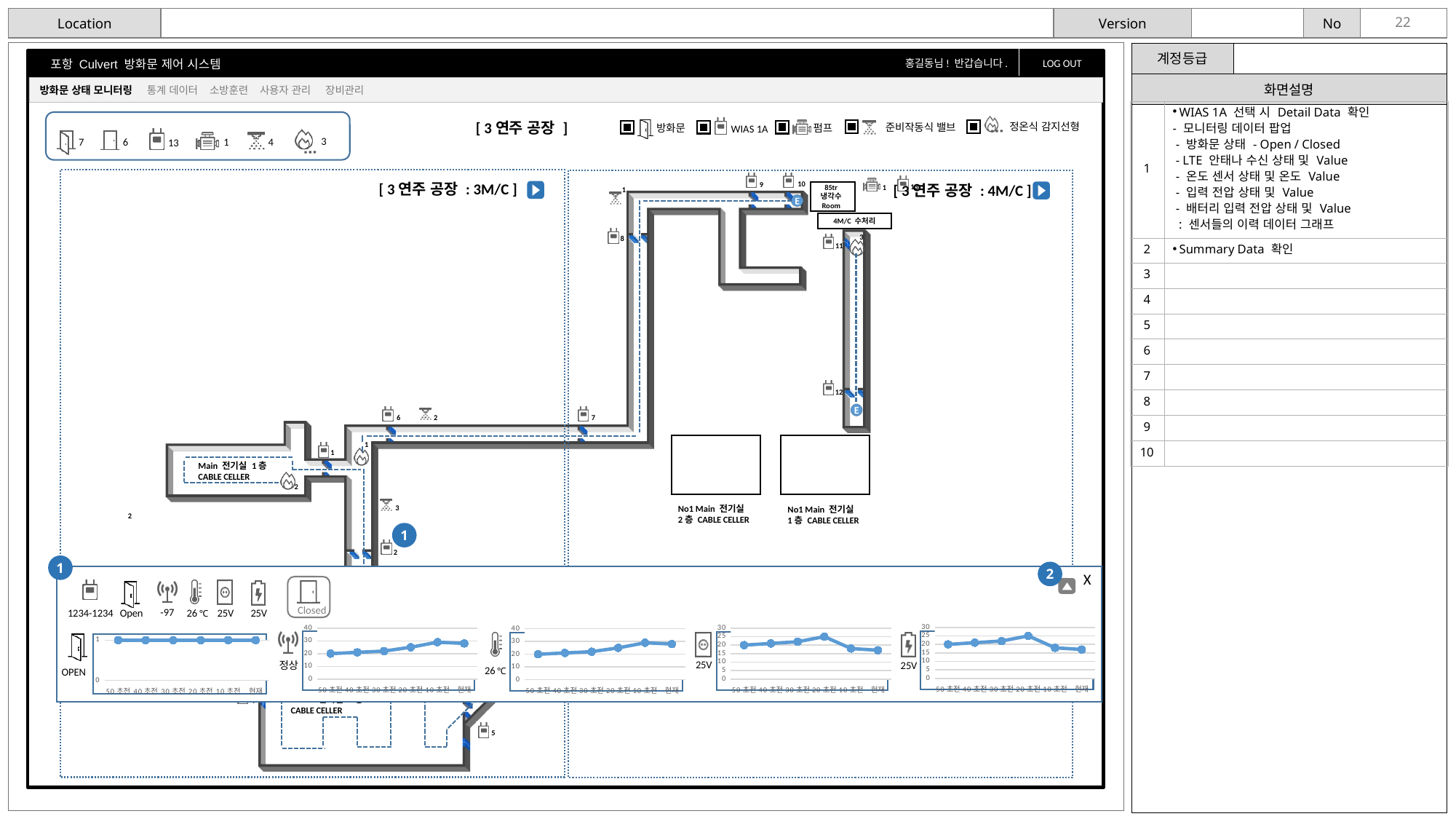
On the second chart from the left in the bottom panel (next to 정상), do the values generally rise or fall from 50 초전 to 현재? rise On the middle chart in the bottom panel (next to 26 ℃), which is larger: the value at 50 초전 or the value at 현재? 현재 On the middle chart in the bottom panel (next to 26 ℃), is the value for 현재 greater or less than 20? greater On the second chart from the left in the bottom panel (next to 정상), is the value for 현재 greater or less than 20? greater On the leftmost chart in the bottom panel (next to OPEN), what value does the line sit at for 현재? 1 What is the first x-axis label on the rightmost chart in the bottom panel (battery 25V)? 50 초전 What kind of chart is the second chart from the left in the bottom panel (next to the 정상 label)? line chart What is the last x-axis label on the leftmost chart in the bottom panel (next to OPEN)? 현재 On the fourth chart from the left in the bottom panel (next to the 25V plug icon), is the value for 현재 greater or less than 25? less On the fourth chart from the left in the bottom panel (next to the 25V plug icon), which x-axis point has the highest value? 20 초전 How many data points are plotted on the middle chart in the bottom panel (next to the 26 ℃ label)? 6 On the rightmost chart in the bottom panel (battery 25V), which is larger: the value at 20 초전 or the value at 현재? 20 초전